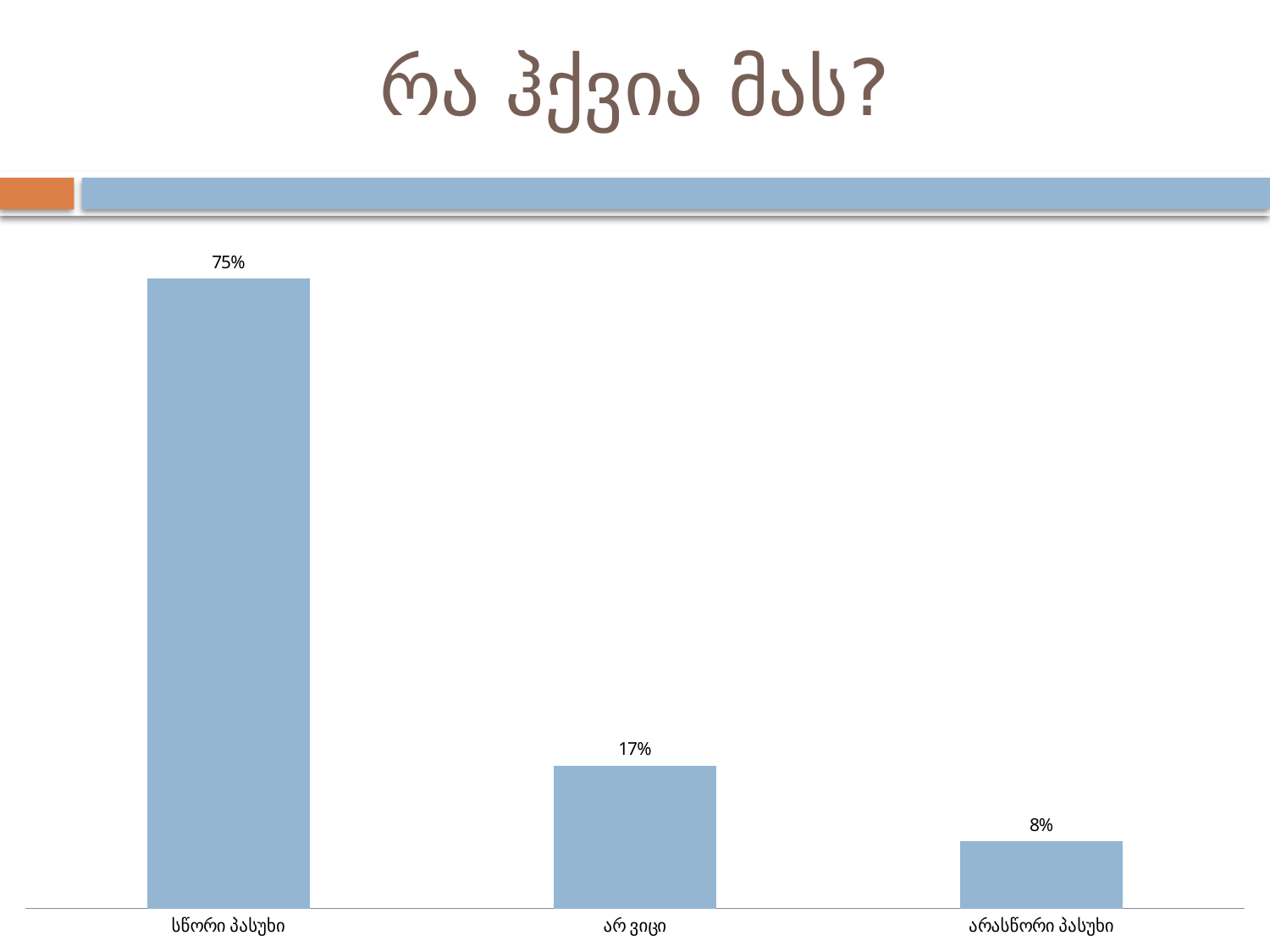
What is the title of the slide? რა ჰქვია მას? What is the difference between the values for სწორი პასუხი and არ ვიცი? 58% What kind of chart is shown on the slide? bar chart What is the value for სწორი პასუხი? 75% Which is larger, the value for არ ვიცი or the value for არასწორი პასუხი? არ ვიცი What is the value for არ ვიცი? 17% What is the difference between the values for არ ვიცი and არასწორი პასუხი? 9% What is the value for არასწორი პასუხი? 8% Do the values rise or fall from left to right across the categories? fall Which category has the highest value? სწორი პასუხი Which category has the lowest value? არასწორი პასუხი How many categories are shown in the chart? 3